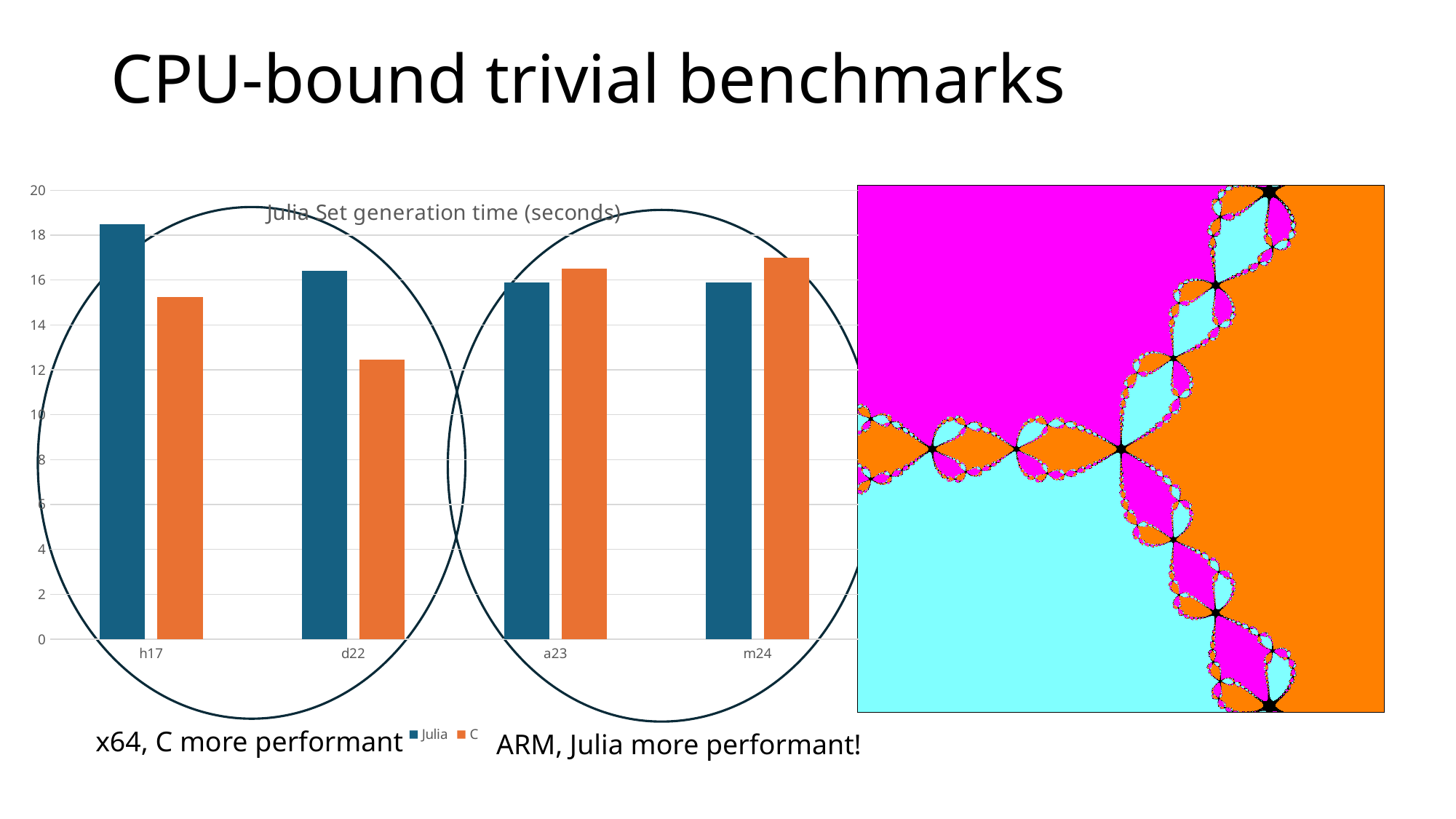
Which colour represents the C series in the chart? orange What kind of chart is shown on the slide? bar chart Is the C value for d22 greater or less than 14? less What is the title of the chart? Julia Set generation time (seconds) How many series does the chart's legend list? 2 For d22, which series has the larger value, Julia or C? Julia For h17, which series has the larger value, Julia or C? Julia Which category has the lowest C value? d22 Is the Julia value for h17 greater or less than 18? greater How many categories are shown on the x axis of the chart? 4 Which category has the highest Julia value? h17 For m24, which series has the larger value, Julia or C? C